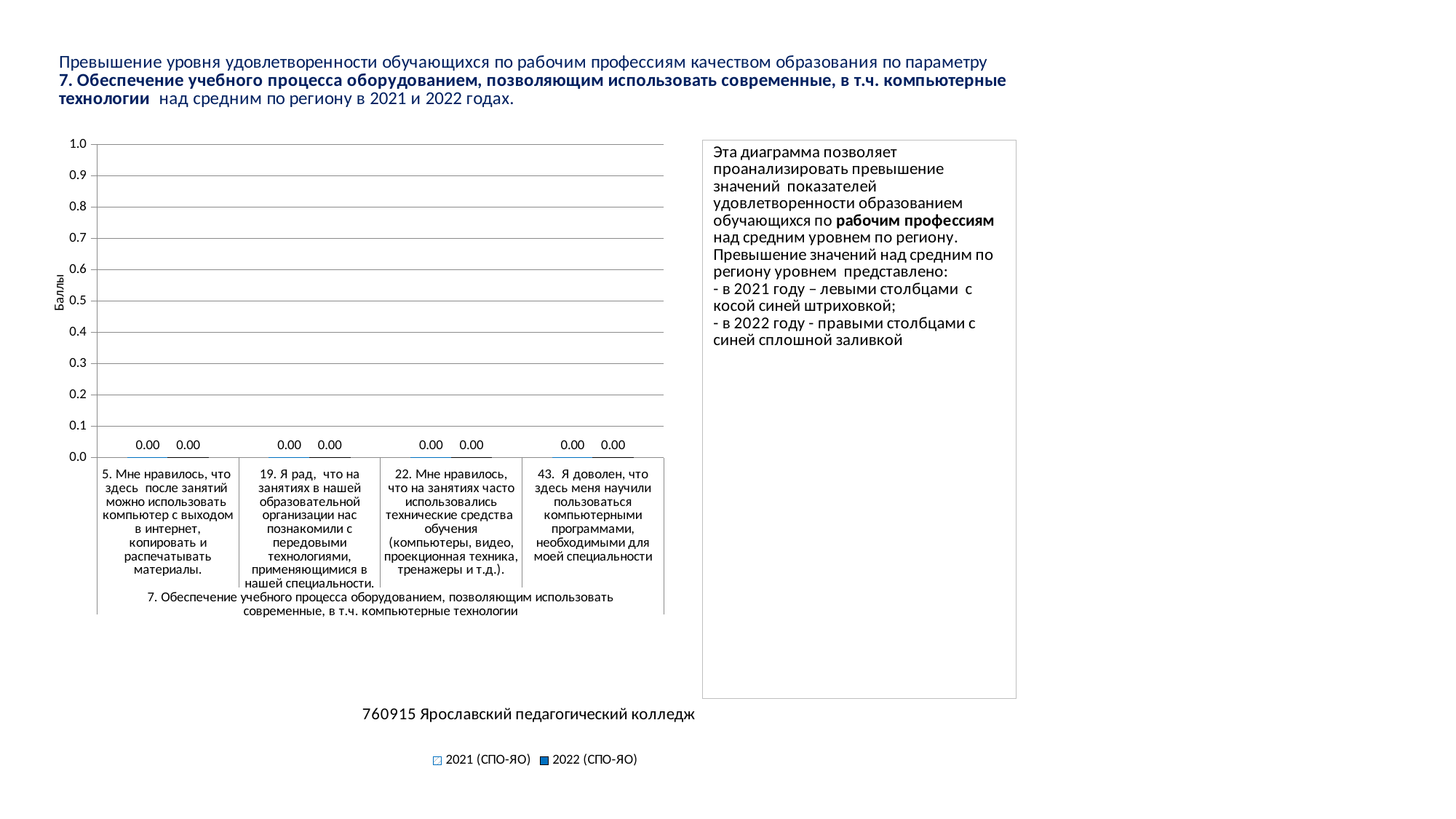
What is the value for 2022 (СПО-ЯО) for category 43 ("Я доволен, что здесь меня научили пользоваться компьютерными программами...")? 0.00 How many categories are shown on the x axis of the chart? 4 How many series does the chart legend list? 2 Do the values for 2021 (СПО-ЯО) rise, fall, or stay the same across the categories? stay the same What kind of chart is shown on the slide? bar chart What is the value for 2021 (СПО-ЯО) for category 5 ("Мне нравилось, что здесь после занятий можно использовать компьютер с выходом в интернет...")? 0.00 What is the difference between the 2021 (СПО-ЯО) and 2022 (СПО-ЯО) values for category 5? 0.00 What is the value for 2022 (СПО-ЯО) for category 19 ("Я рад, что на занятиях в нашей образовательной организации нас познакомили с передовыми технологиями...")? 0.00 What is the value for 2021 (СПО-ЯО) for category 22 ("Мне нравилось, что на занятиях часто использовались технические средства обучения...")? 0.00 Is the value for 2022 (СПО-ЯО) for category 22 greater or less than 0.5? less What are the two series named in the chart legend? 2021 (СПО-ЯО) and 2022 (СПО-ЯО) What is the label of the vertical axis of the chart? Баллы